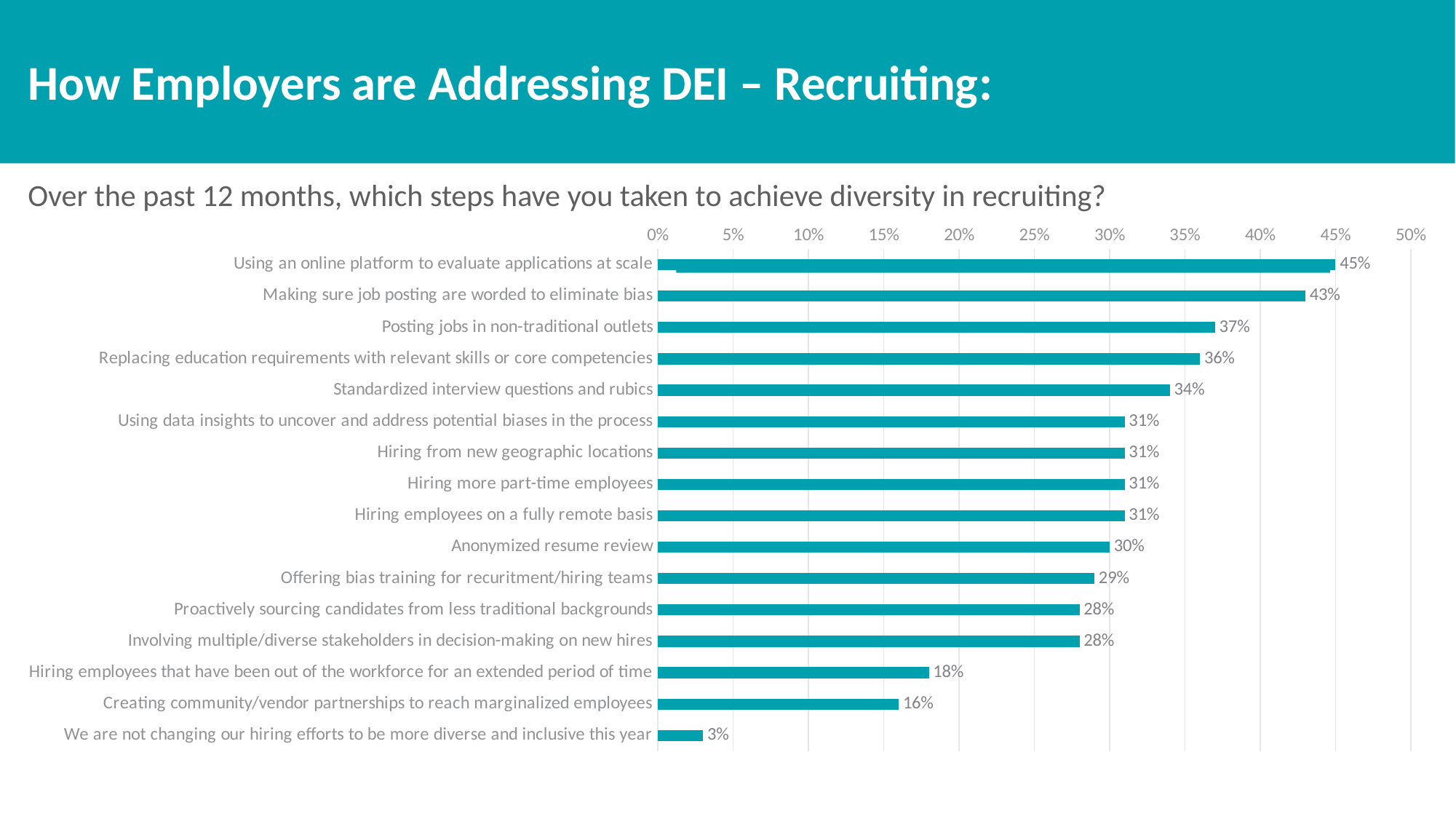
What is the maximum value shown on the percentage axis? 50% What percentage of employers reported creating community/vendor partnerships to reach marginalized employees? 16% What kind of chart is shown on the slide? Bar chart What is the difference between the values for 'Making sure job posting are worded to eliminate bias' and 'Anonymized resume review'? 13% What is the value for 'Replacing education requirements with relevant skills or core competencies'? 36% What percentage of employers reported using an online platform to evaluate applications at scale? 45% Is the value for 'Hiring employees that have been out of the workforce for an extended period of time' greater or less than 20%? less Which is larger: the value for 'Standardized interview questions and rubics' or the value for 'Offering bias training for recuritment/hiring teams'? Standardized interview questions and rubics How many categories are shown in the chart? 16 Which step has the highest percentage in the chart? Using an online platform to evaluate applications at scale Which category has the lowest value in the chart? We are not changing our hiring efforts to be more diverse and inclusive this year What is the value for 'Posting jobs in non-traditional outlets'? 37%